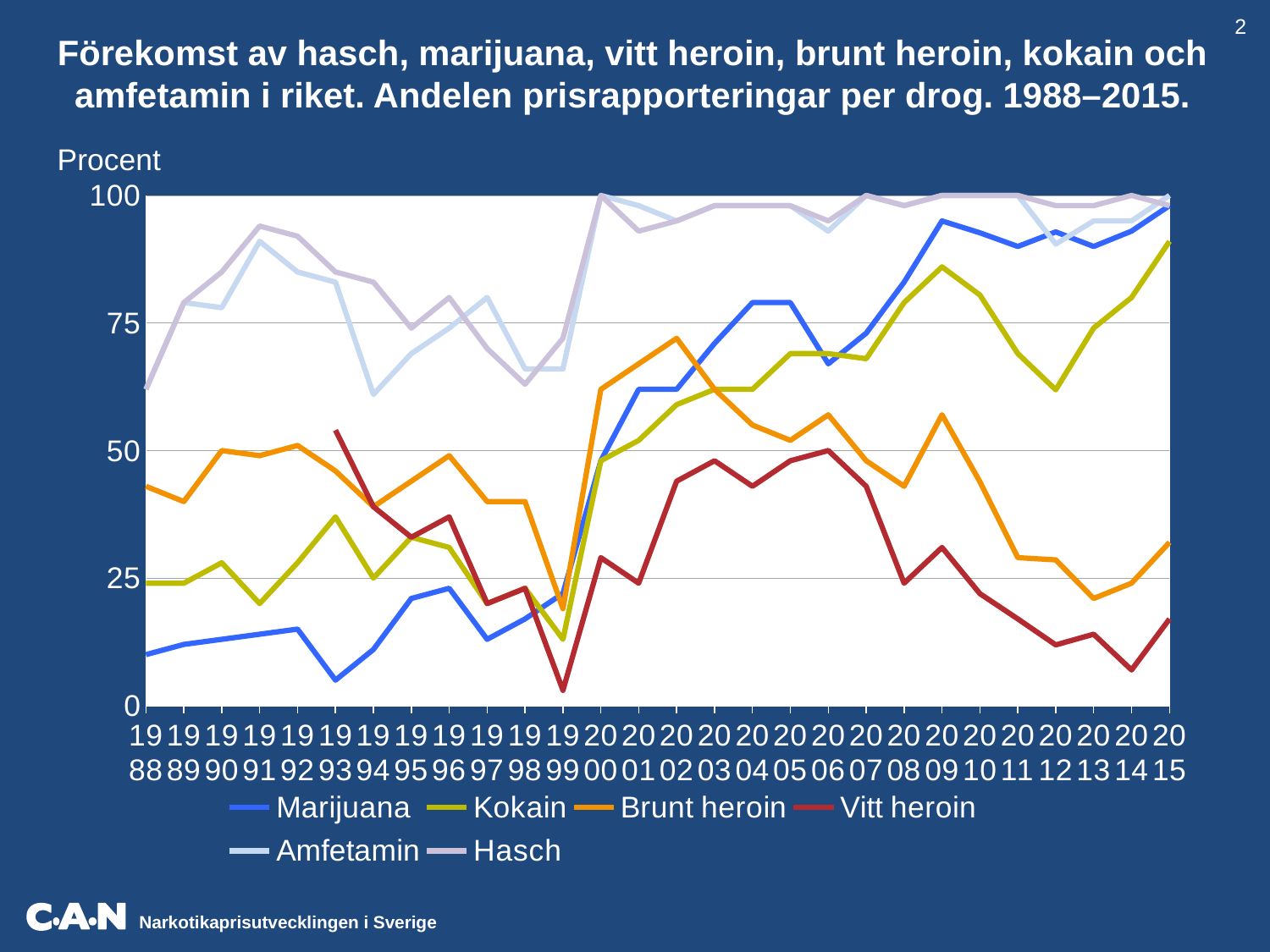
Which series has the higher value in 2015, Marijuana or Vitt heroin? Marijuana Is the value for Marijuana in 1988 greater or less than 25? less What kind of chart is shown on the slide? line chart How many series does the legend list? 6 Does the Marijuana line overall rise or fall from 1988 to 2015? rise How many years are plotted along the x axis? 28 In which year does the Vitt heroin line reach its lowest value? 1999 Is the value for Brunt heroin in 2002 greater or less than 50? greater Is the value for Vitt heroin in 1999 greater or less than 25? less Which series has the higher value in 1988, Kokain or Brunt heroin? Brunt heroin What colour is the Vitt heroin line in the legend? red